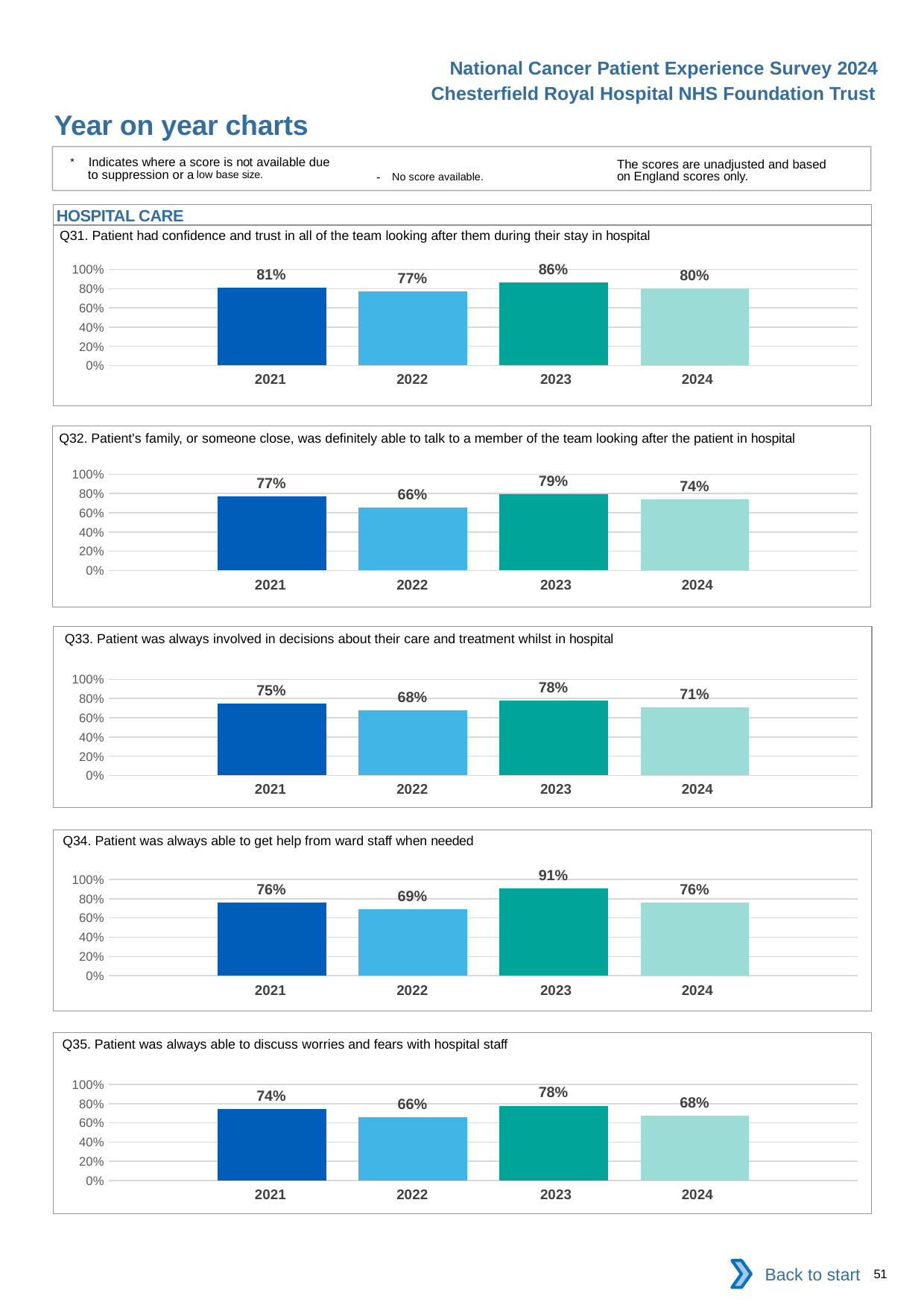
How many bars are shown in the Q32 chart? 4 In the Q31 chart, is the value for 2021 or 2024 larger? 2021 In the Q34 chart, what is the value for 2022? 69% What type of chart is the Q34 chart? Bar chart In the Q33 chart, what is the difference between the 2023 and 2022 values? 10% How many charts are shown on the slide? 5 In the Q34 chart, which year has the highest value? 2023 In the Q35 chart, what is the value for 2024? 68% In the Q35 chart, what is the difference between the 2021 and 2022 values? 8% In the Q33 chart, is the value for 2024 greater or less than 80%? less In the Q31 chart, what is the value for 2023? 86% In the Q32 chart, which year has the lowest value? 2022